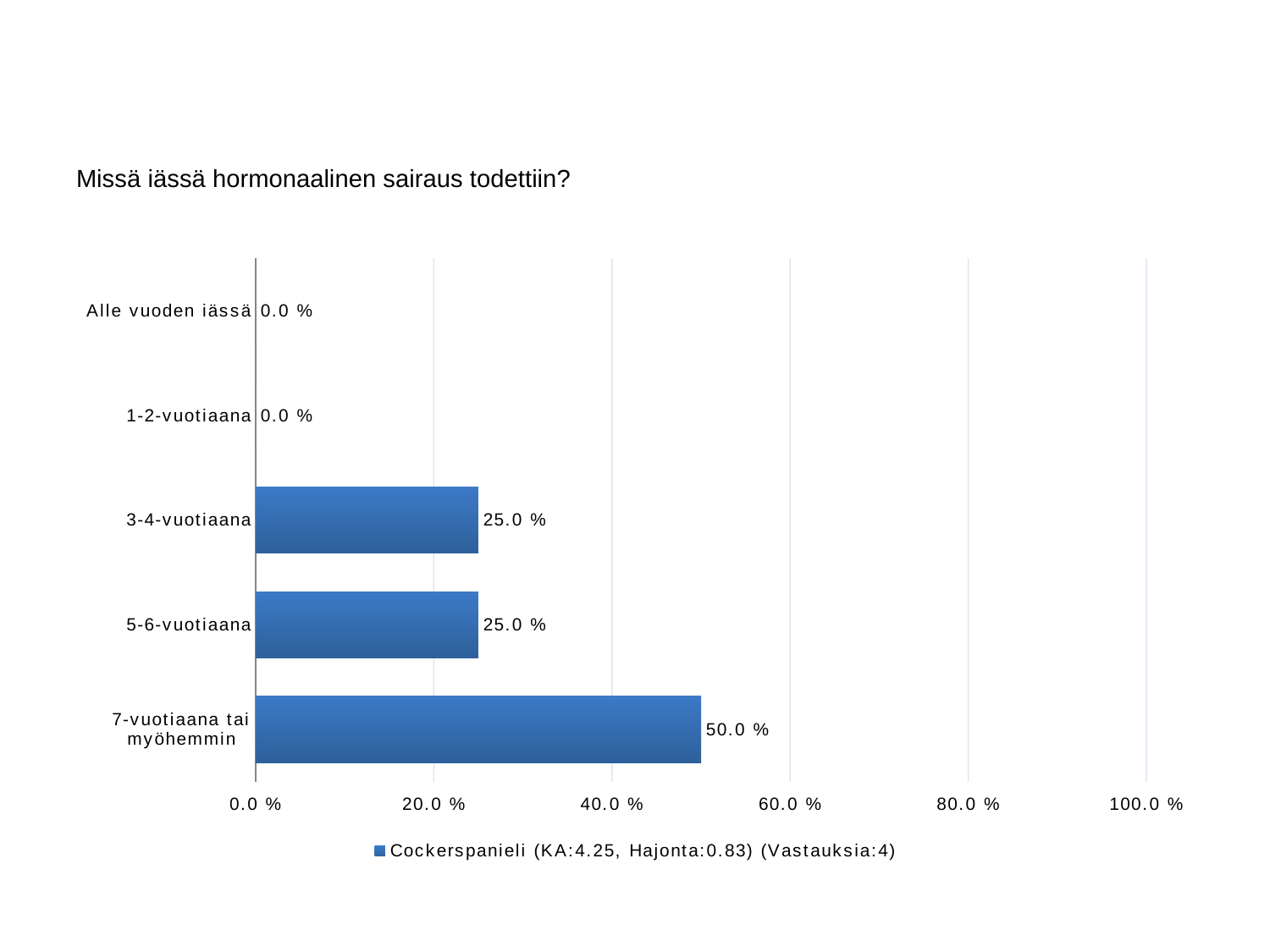
Is the value for 7-vuotiaana tai myöhemmin greater or less than 40.0 %? greater Which is larger, the value for 7-vuotiaana tai myöhemmin or the value for 3-4-vuotiaana? 7-vuotiaana tai myöhemmin What is the title of the chart? Missä iässä hormonaalinen sairaus todettiin? What is the difference between the values for 7-vuotiaana tai myöhemmin and 5-6-vuotiaana? 25.0 % What kind of chart is shown on the slide? bar chart How many categories have a value of 0.0 %? 2 How many categories are shown on the chart? 5 What is the value for 7-vuotiaana tai myöhemmin? 50.0 % How many series does the legend list? 1 What is the value for 3-4-vuotiaana? 25.0 % Which category has the highest value? 7-vuotiaana tai myöhemmin What is the value for Alle vuoden iässä? 0.0 %